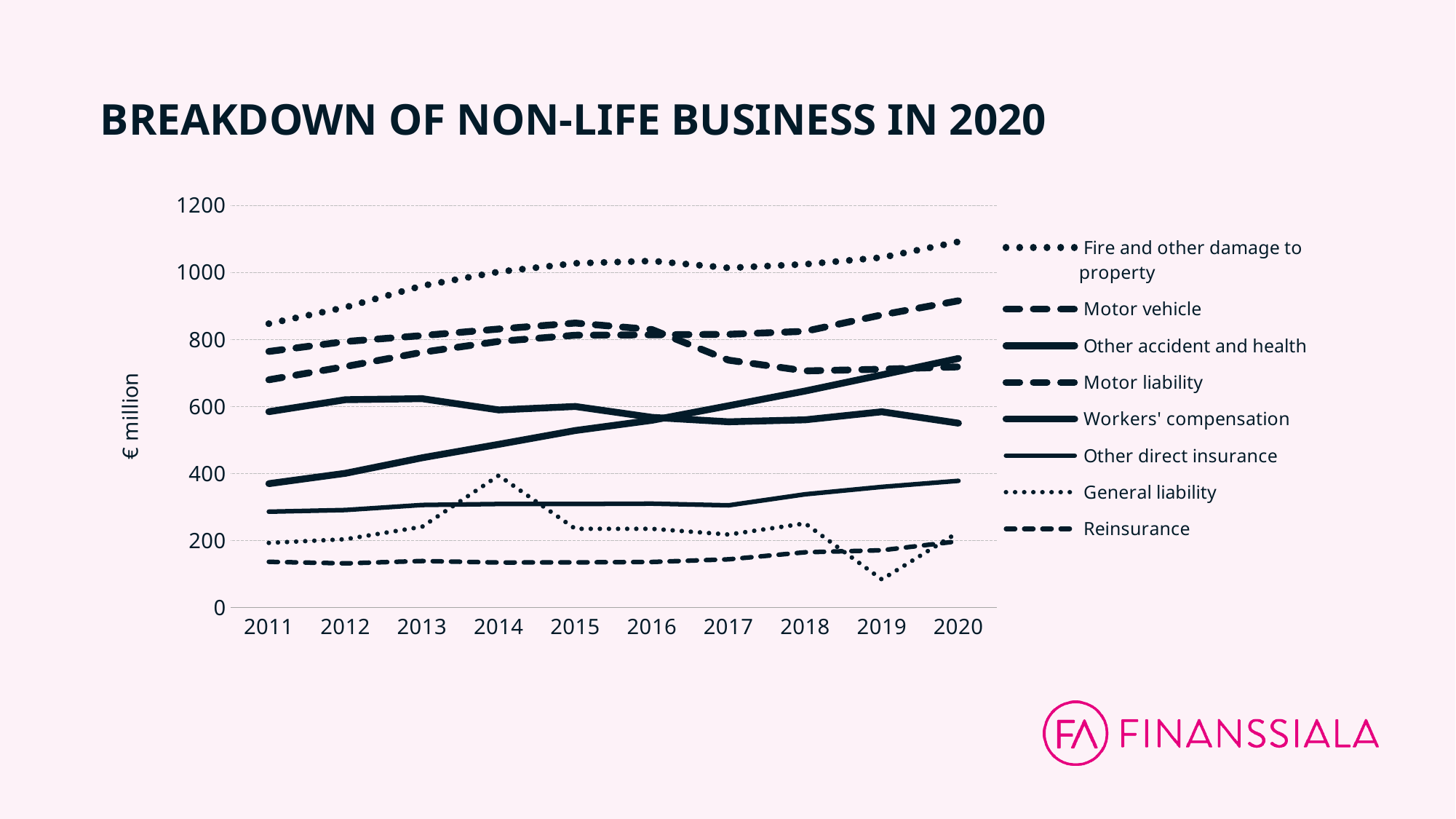
What is the label on the y axis? € million How many years are shown along the x axis? 10 In which year does the General liability series reach its peak? 2014 Which series has the highest value in 2020? Fire and other damage to property Is the value for Fire and other damage to property in 2020 greater or less than 1000? greater How many series does the legend list? 8 What kind of chart is shown on the slide? line chart Is the value for General liability in 2019 greater or less than 200? less Which series has the lowest value in 2011? Reinsurance